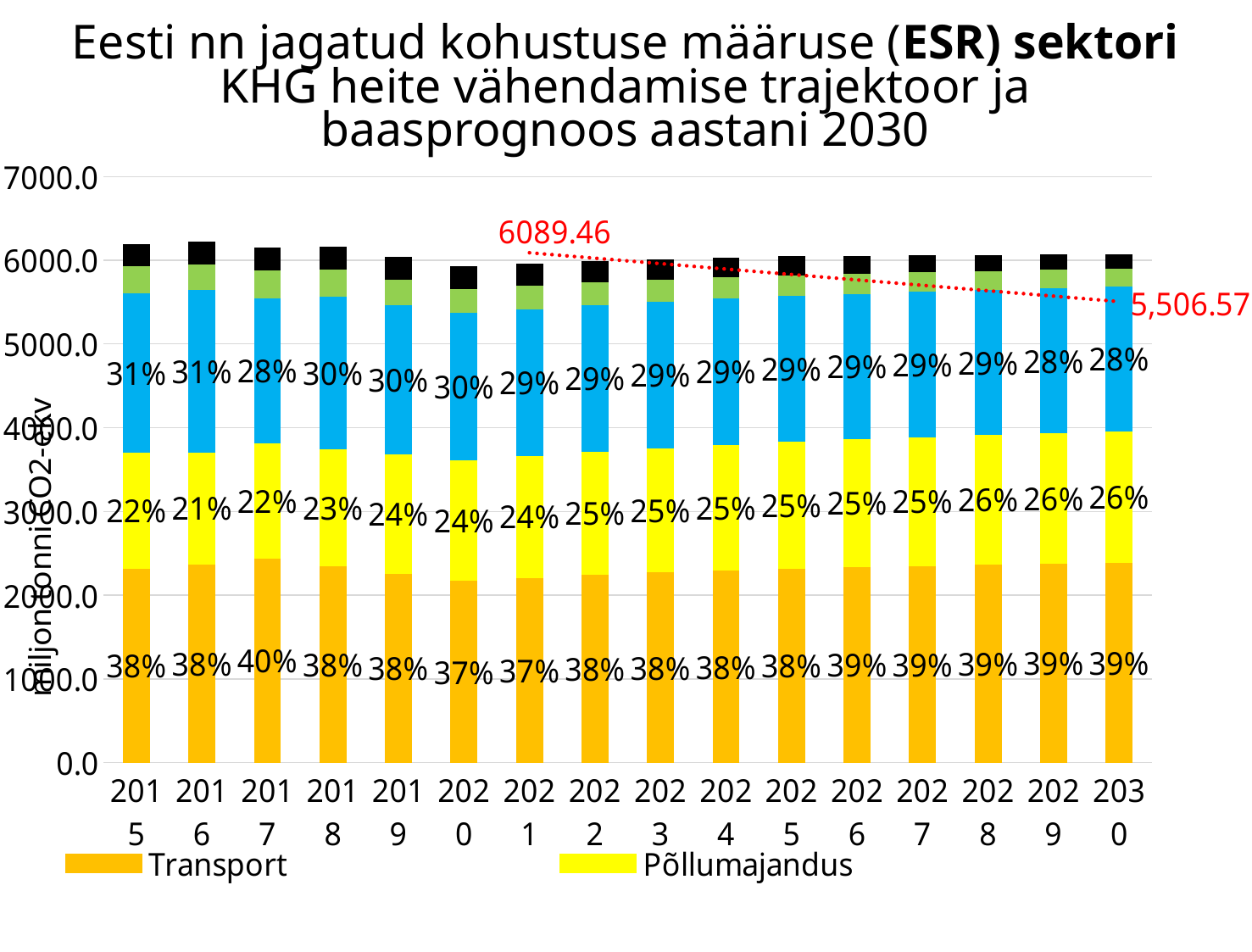
Is the total height of the 2020 stacked bar greater or less than 6000? less In which year is the Põllumajandus share the lowest? 2016 By how many percentage points does the Põllumajandus share in 2030 exceed its share in 2015? 4 percentage points What percentage share does Põllumajandus have in 2030? 26% In which year is the Transport share the highest? 2017 What value is labelled at the right end of the dotted red line? 5,506.57 Does the Põllumajandus share rise or fall from 2015 to 2030? Rises In 2020, which has the larger share, Transport or Põllumajandus? Transport How many years are shown on the x axis? 16 What kind of chart is shown on the slide? Stacked bar chart Is the total height of the 2016 stacked bar greater or less than 6000? greater What percentage share does Transport have in 2017? 40%